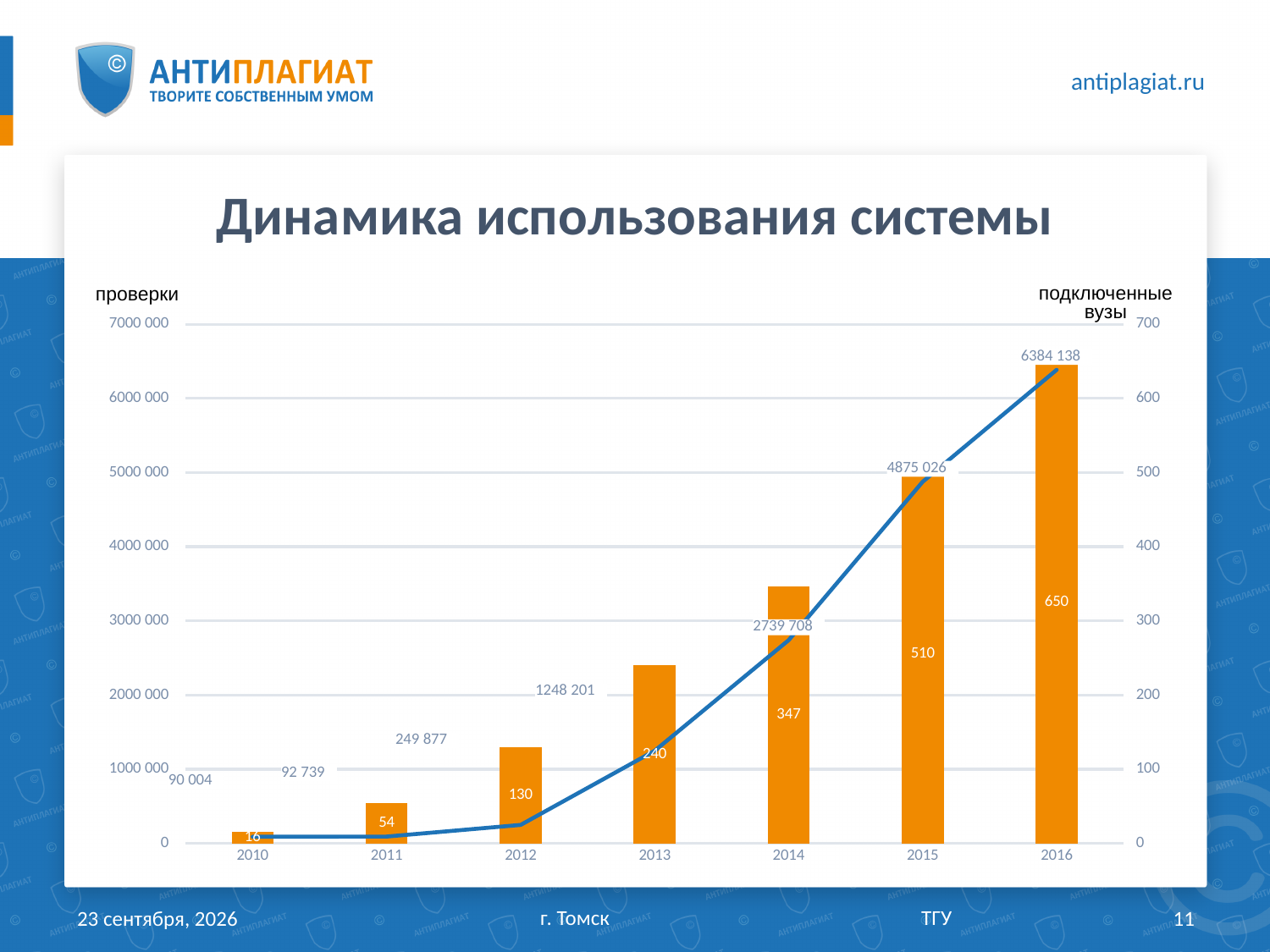
What is the number of checks (проверки) shown for 2010? 90 004 Which is larger: the number of connected universities in 2014 or in 2012? 2014 How many connected universities (подключенные вузы) are shown for 2016? 650 How many connected universities (подключенные вузы) are shown for 2013? 240 Do the number of checks (проверки) rise or fall from 2010 to 2016? rise What is the difference in connected universities between 2016 and 2015? 140 How many years are shown on the x axis? 7 What is the difference in checks (проверки) between 2011 and 2010? 2 735 Which year has the lowest number of checks (проверки)? 2010 What is the title of the chart? Динамика использования системы What is the number of checks (проверки) shown for 2014? 2739 708 Which year has the highest number of connected universities? 2016